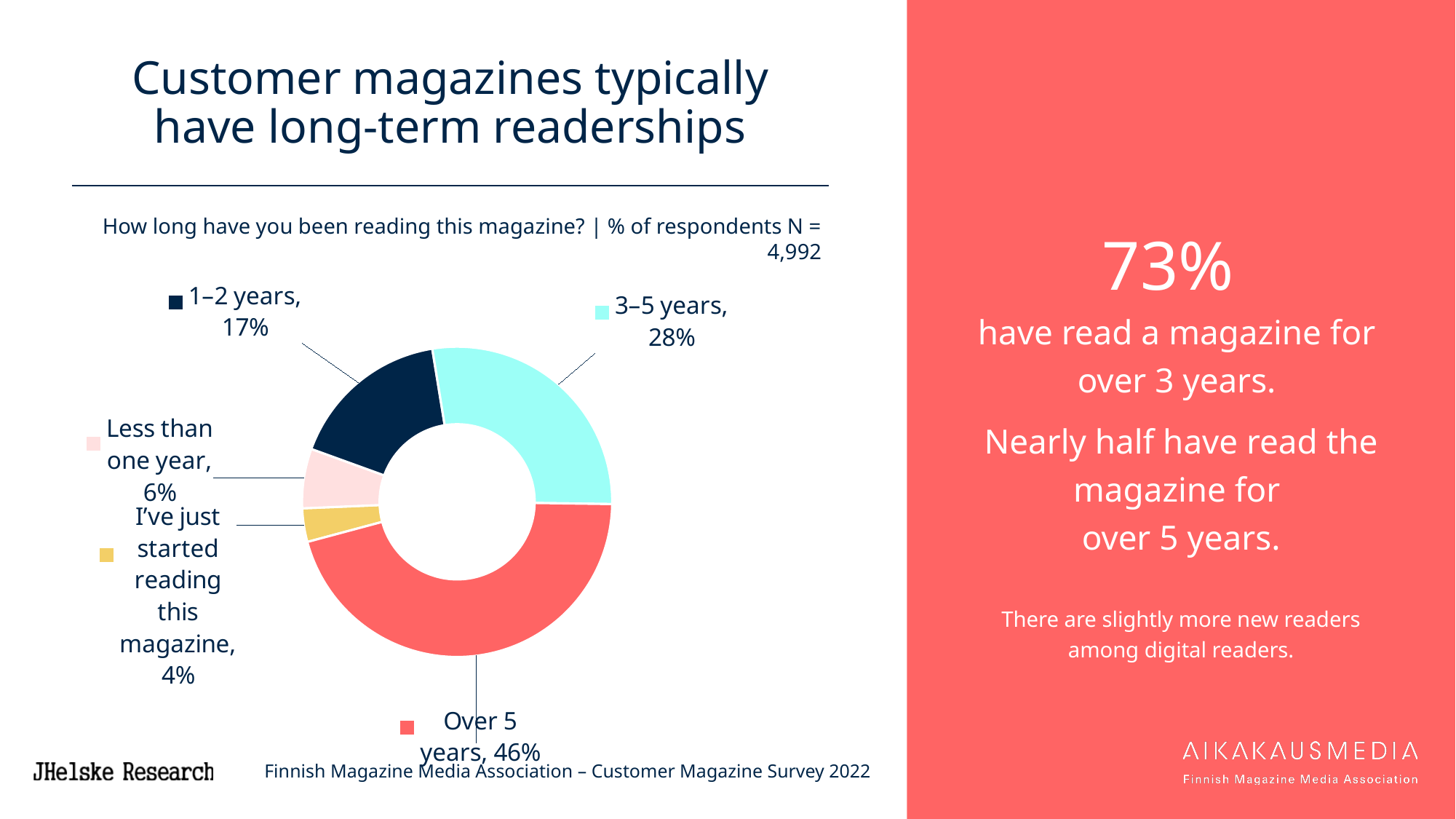
Which is larger: the share for 1–2 years or the share for less than one year? 1–2 years What percentage of respondents have been reading the magazine for over 5 years? 46% Which category has the smallest share of respondents? I've just started reading this magazine What is the number of respondents (N) stated in the chart subtitle? 4,992 What percentage of respondents have been reading the magazine for 3–5 years? 28% Which category has the largest share of respondents? Over 5 years What is the difference in percentage points between the 'Over 5 years' and '3–5 years' categories? 18 How many categories are shown in the chart? 5 What percentage of respondents say they have just started reading the magazine? 4% What percentage of respondents have been reading the magazine for less than one year? 6% What kind of chart is shown on the slide? Doughnut (pie) chart What percentage of respondents have been reading the magazine for 1–2 years? 17%